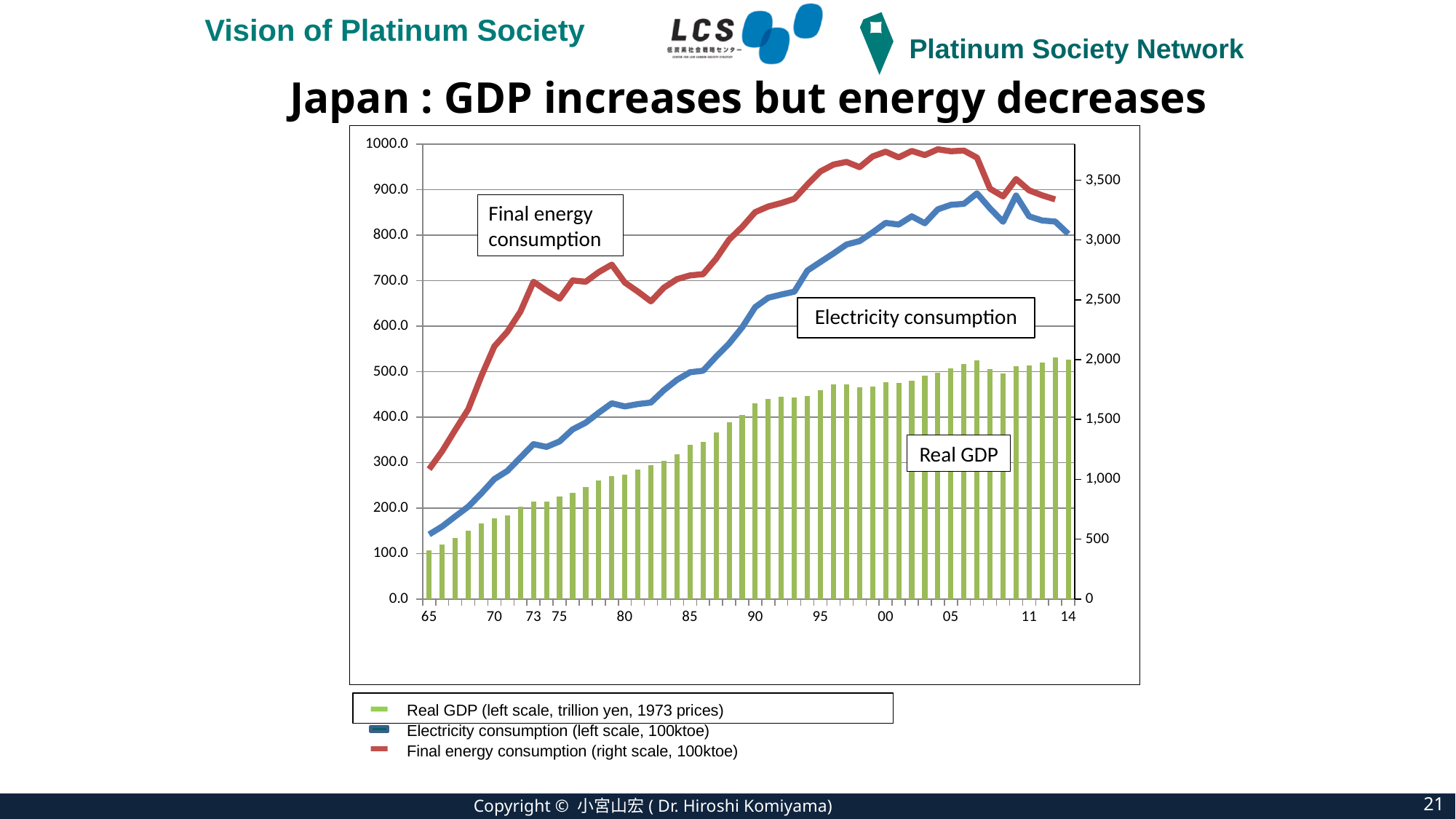
Does Real GDP generally rise or fall from 65 to 14? Rise What is the title of the slide's chart? Japan : GDP increases but energy decreases Which is larger, Real GDP in 65 or Real GDP in 14? Real GDP in 14 In 90, which is larger on the left scale, Electricity consumption or Real GDP? Electricity consumption Is the value of Real GDP in 14 greater or less than 500? greater Is the value of Electricity consumption in 05 greater or less than 800? greater Which series is plotted on the right scale? Final energy consumption Is the value of Final energy consumption in 73 (right scale) greater or less than 2,500? greater What kind of chart is shown on the slide? A combined bar and line chart How many series does the legend list? 3